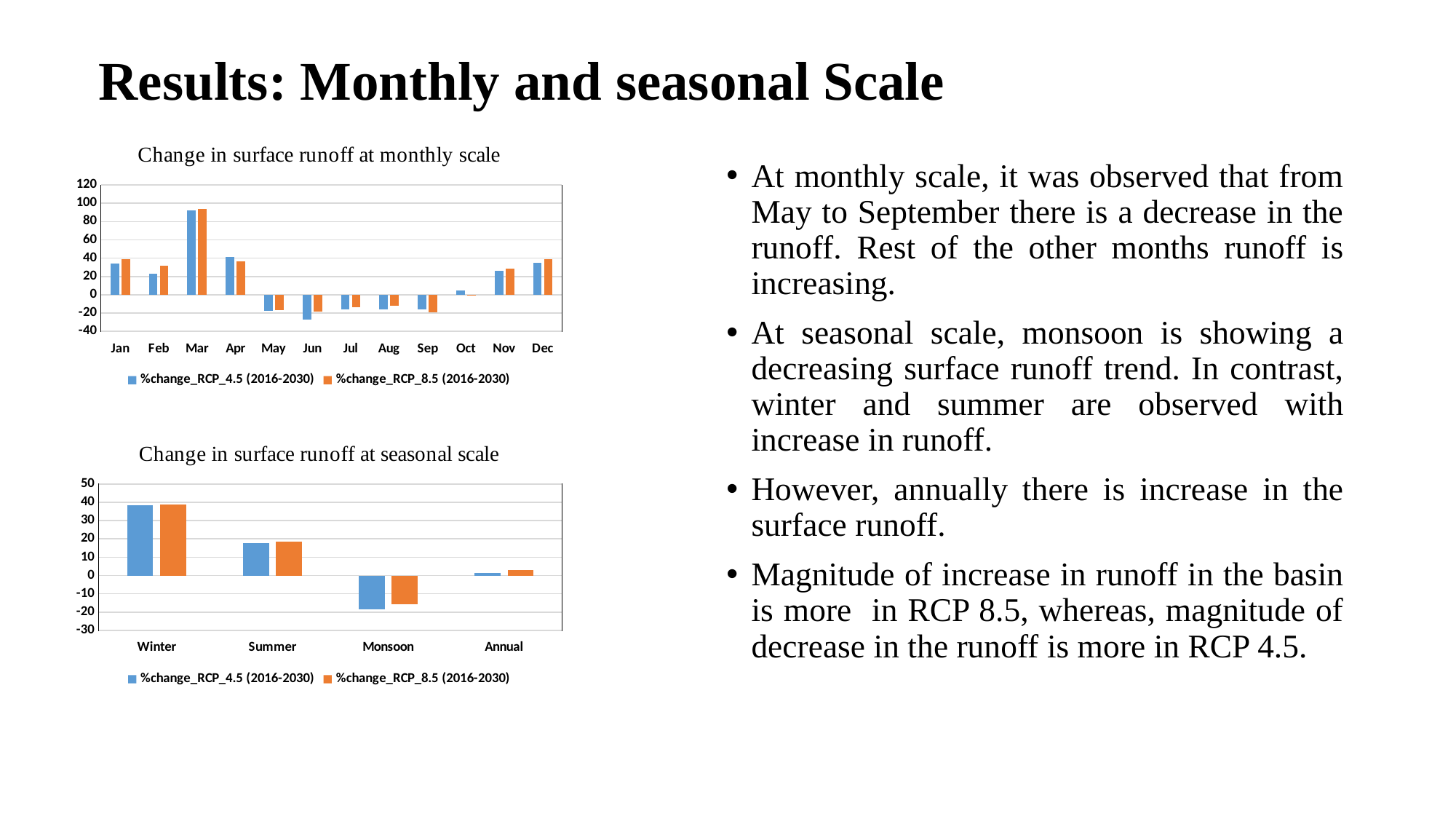
In the 'Change in surface runoff at monthly scale' chart, which month has the highest value for %change_RCP_4.5 (2016-2030)? Mar In the 'Change in surface runoff at seasonal scale' chart, is the value for Winter in the %change_RCP_4.5 (2016-2030) series greater or less than 30? greater In the 'Change in surface runoff at monthly scale' chart, is the value for Mar in the %change_RCP_4.5 (2016-2030) series greater or less than 80? greater In the 'Change in surface runoff at seasonal scale' chart, which season has the highest value for %change_RCP_8.5 (2016-2030)? Winter What kind of chart is the 'Change in surface runoff at seasonal scale' chart? Bar chart In the 'Change in surface runoff at seasonal scale' chart, how many series does the legend list? 2 In the 'Change in surface runoff at monthly scale' chart, which is larger for %change_RCP_8.5 (2016-2030): Jan or Feb? Jan In the 'Change in surface runoff at monthly scale' chart, which month has the lowest value for %change_RCP_4.5 (2016-2030)? Jun In the 'Change in surface runoff at seasonal scale' chart, is the value for Monsoon in the %change_RCP_4.5 (2016-2030) series greater or less than -10? less In the 'Change in surface runoff at monthly scale' chart, how many months are shown on the x axis? 12 In the 'Change in surface runoff at seasonal scale' chart, which category has the lowest value for %change_RCP_4.5 (2016-2030)? Monsoon